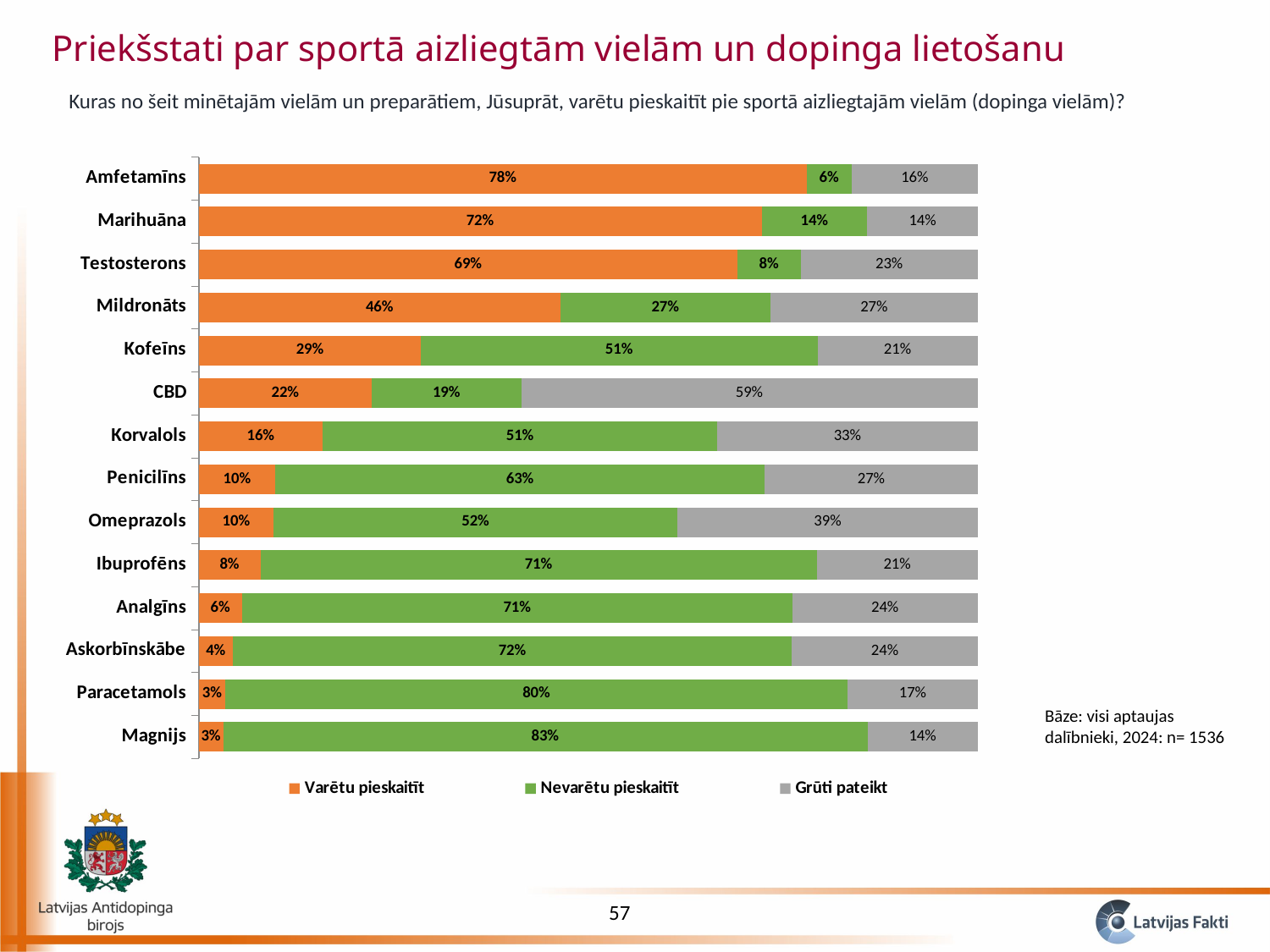
How many series does the legend list? 3 What is the "Varētu pieskaitīt" value for Amfetamīns? 78% What is the "Nevarētu pieskaitīt" value for Penicilīns? 63% What is the "Grūti pateikt" value for CBD? 59% Which substance has the lowest "Varētu pieskaitīt" value? Paracetamols and Magnijs (3%) How many substances (categories) are listed on the chart? 14 What kind of chart is shown on the slide? Stacked bar chart Which legend entry is shown in orange? Varētu pieskaitīt What is the difference between the "Varētu pieskaitīt" values for Amfetamīns and Marihuāna? 6 percentage points What is the total of the three segments for the Amfetamīns bar? 100% Which substance has the highest "Nevarētu pieskaitīt" value? Magnijs Which is larger: the "Grūti pateikt" value for Omeprazols or for Korvalols? Omeprazols